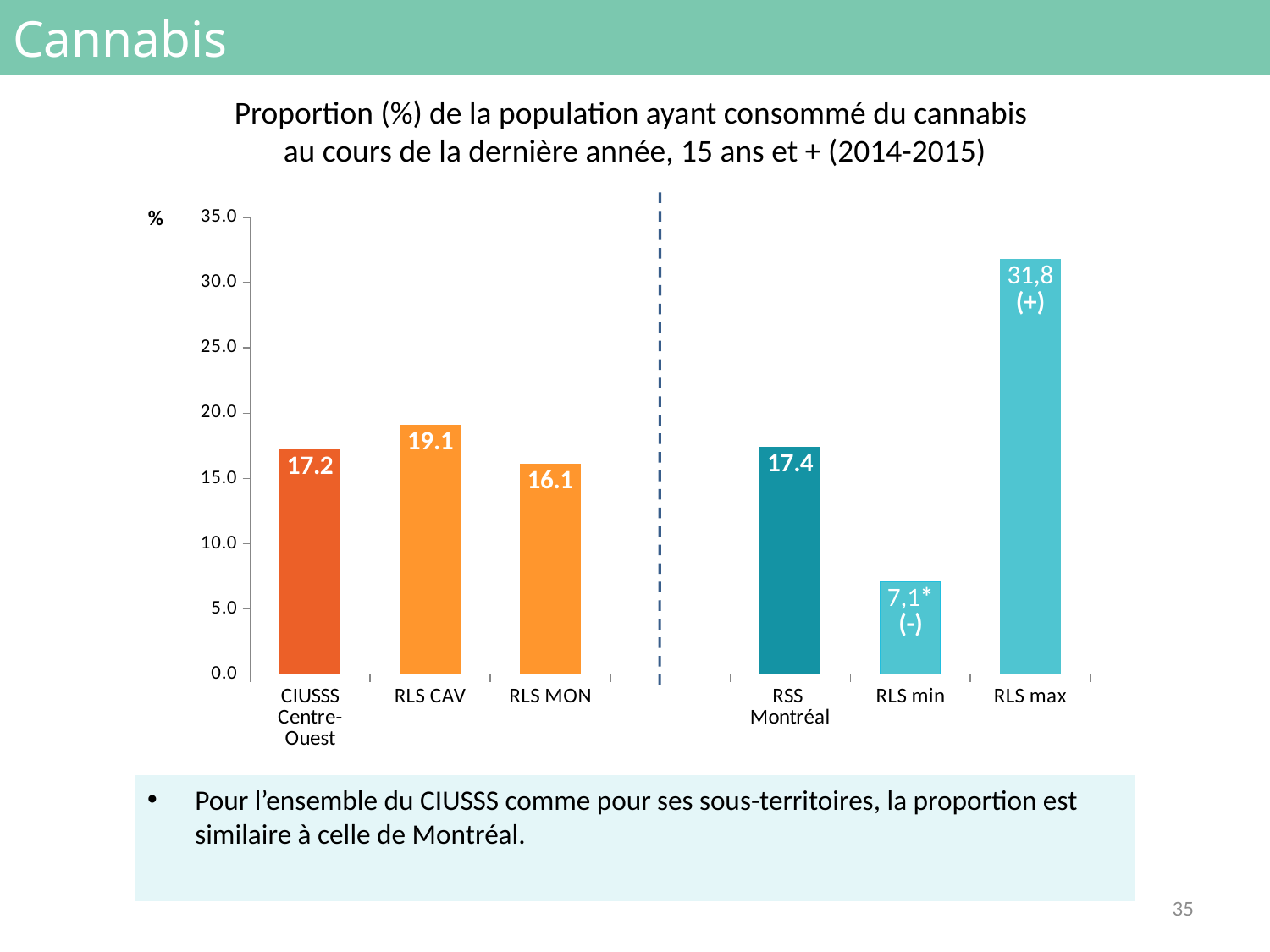
How many categories are shown on the x axis? 6 What value is labelled on the RLS max bar? 31,8 What type of chart is shown on the slide? bar chart What is the difference between the values for RLS CAV and CIUSSS Centre-Ouest? 1.9 Which is larger, the value for RLS CAV or the value for RSS Montréal? RLS CAV Which category has the lowest value? RLS min What is the value for RSS Montréal? 17.4 What is the value for RLS MON? 16.1 Is the value for RLS min greater or less than 10.0? less What is the value for RLS CAV? 19.1 What is the value for CIUSSS Centre-Ouest? 17.2 Which category has the highest value? RLS max